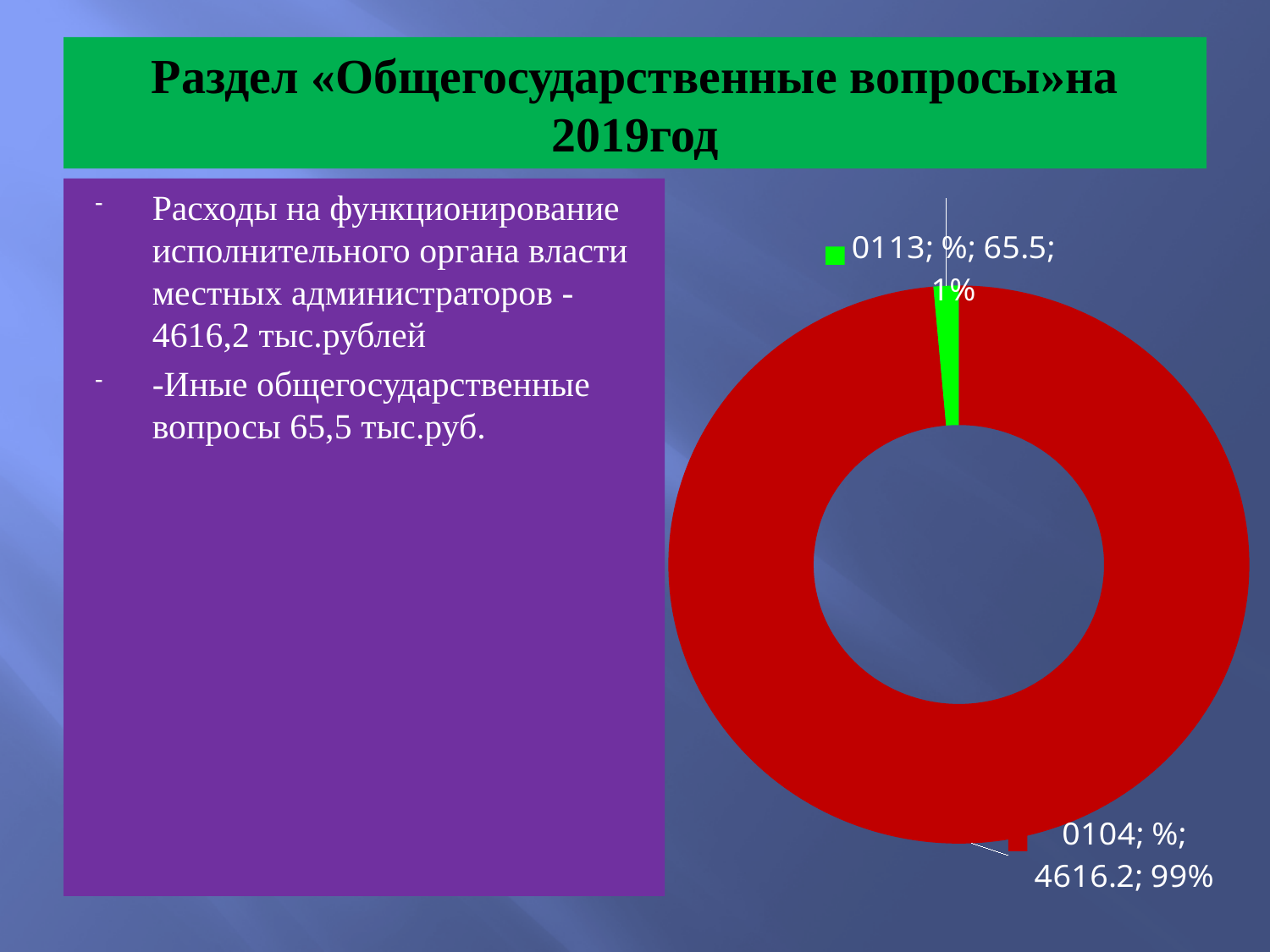
How many slices does the doughnut chart have? 2 What kind of chart is shown on the slide? Doughnut chart What value is shown for category 0113 in the chart? 65.5 Which is larger, the value for 0104 or the value for 0113? 0104 Which category has the largest slice in the chart? 0104 What percentage share does category 0113 have in the chart? 1% What percentage share does category 0104 have in the chart? 99% What is the difference between the values for 0104 and 0113? 4550.7 What colour is the slice for category 0113? Green What colour is the slice for category 0104? Red What value is shown for category 0104 in the chart? 4616.2 Which category has the smallest slice in the chart? 0113